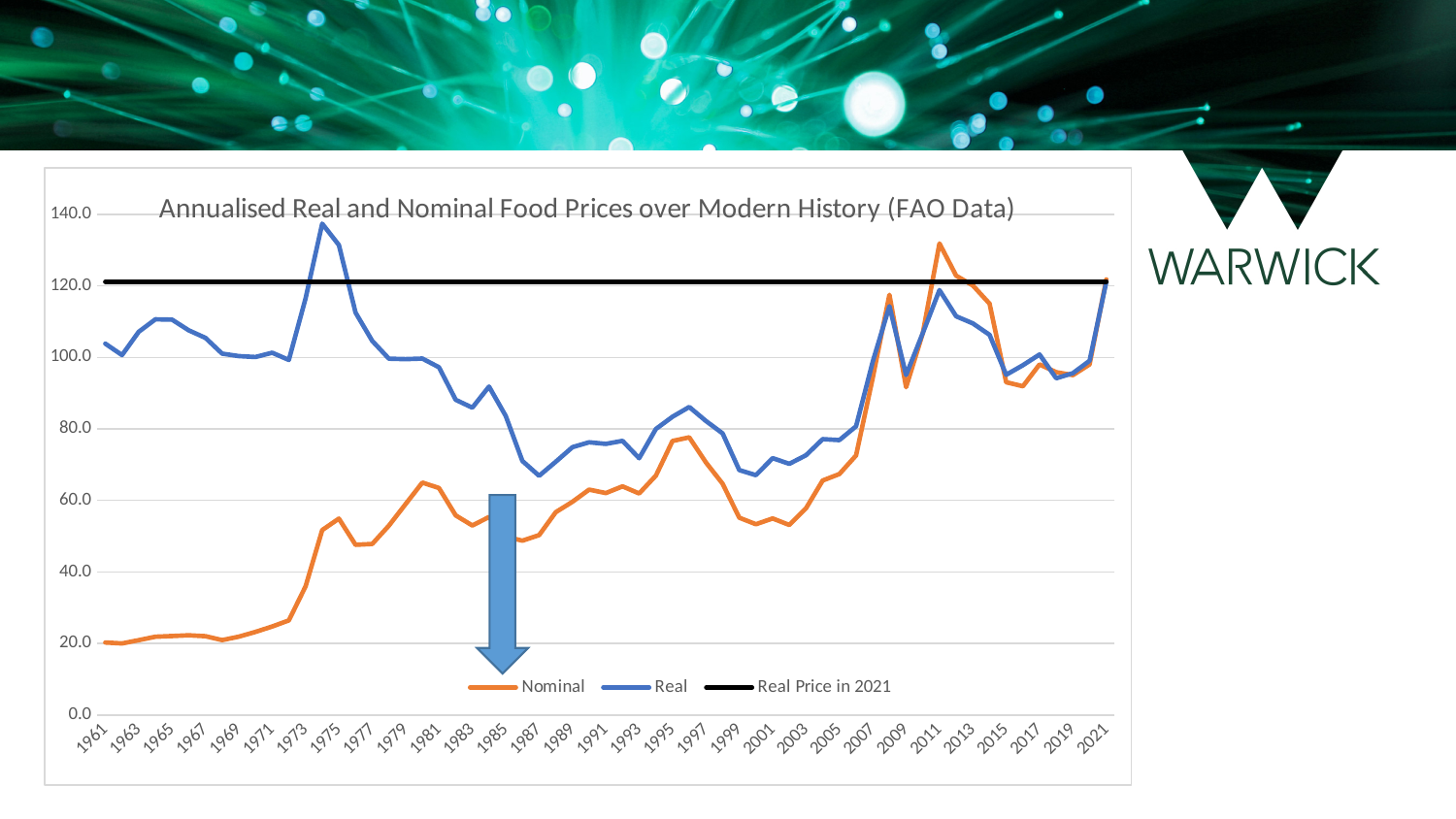
How many series does the legend list? 3 Is the Real value for 1987 greater or less than 80? less What is the title of the chart? Annualised Real and Nominal Food Prices over Modern History (FAO Data) Which colour is used for the Nominal series? Orange Is the Nominal value for 2011 greater or less than 120? greater What kind of chart is shown on the slide? Line chart Does the Nominal series rise or fall between 1961 and 1975? Rise In which year does the Nominal series reach its highest value? 2011 Which series is higher in 1961, Nominal or Real? Real Which series reaches the highest value anywhere on the chart? Real Is the Nominal value for 1961 greater or less than 40? less